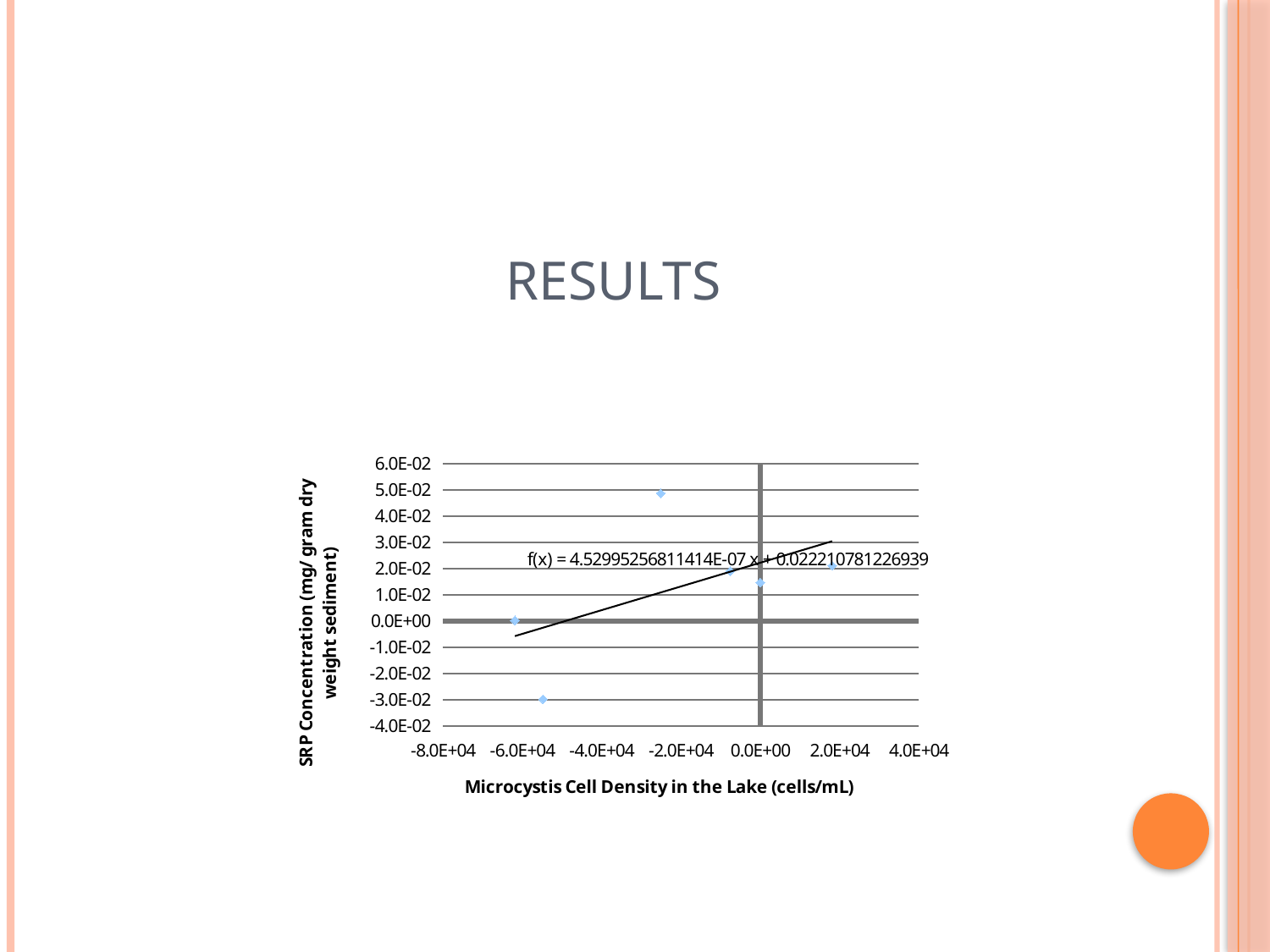
Is the SRP concentration of the point plotted near a cell density of 2.0E+04 greater or less than 1.0E-02? greater What is the slope of the fitted line shown in the equation on the chart? 4.52995256811414E-07 Is the SRP concentration of the lowest plotted point greater or less than -2.0E-02? less Is the SRP concentration of the highest plotted point greater or less than 4.0E-02? greater What is the intercept of the fitted line shown in the equation on the chart? 0.022210781226939 What kind of chart is shown on the slide? scatter plot What is the title of the y axis? SRP Concentration (mg/ gram dry weight sediment) How many data points are plotted on the chart? 6 What is the title of the x axis? Microcystis Cell Density in the Lake (cells/mL) Does the fitted trendline rise or fall as Microcystis cell density increases along the x axis? rises Which has the higher SRP concentration: the point plotted near a cell density of -2.0E+04 or the point plotted at 0.0E+00? the point near -2.0E+04